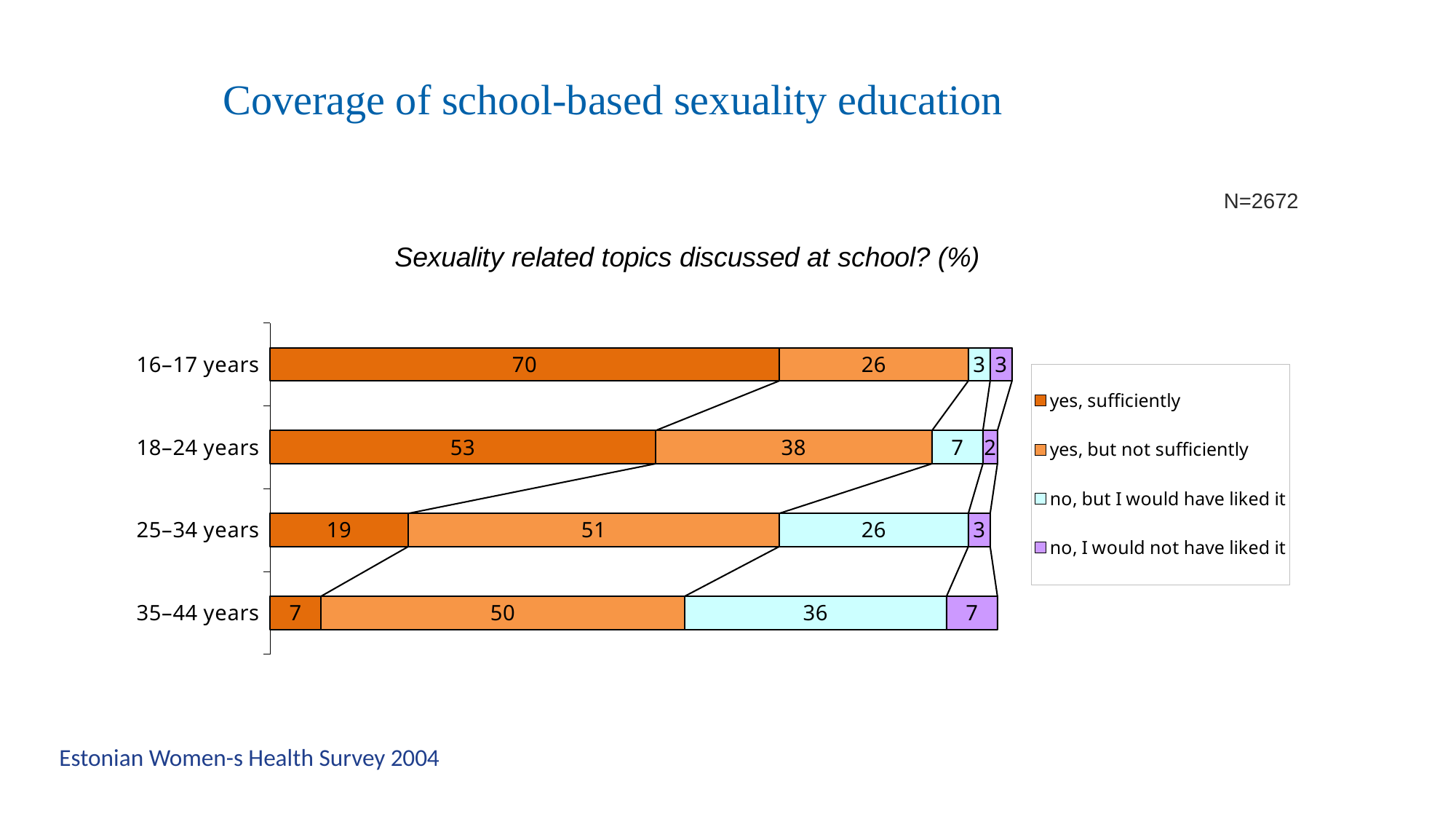
Which age group has the lowest value for "yes, sufficiently"? 35–44 years Does the "yes, sufficiently" value rise or fall as the age groups go from 16–17 years to 35–44 years? Fall What is the value for "no, but I would have liked it" in the 35–44 years group? 36 Which age group has the larger value for "yes, but not sufficiently": 18–24 years or 25–34 years? 25–34 years What kind of chart is shown on the slide? Stacked bar chart What is the value for "yes, sufficiently" in the 16–17 years group? 70 Which age group has the highest value for "yes, sufficiently"? 16–17 years How many age groups are shown in the chart? 4 How many series does the legend list? 4 What is the title of the chart? Sexuality related topics discussed at school? (%) What is the total of the stacked bar for the 18–24 years group? 100 What is the difference between the "yes, sufficiently" values for 18–24 years and 25–34 years? 34